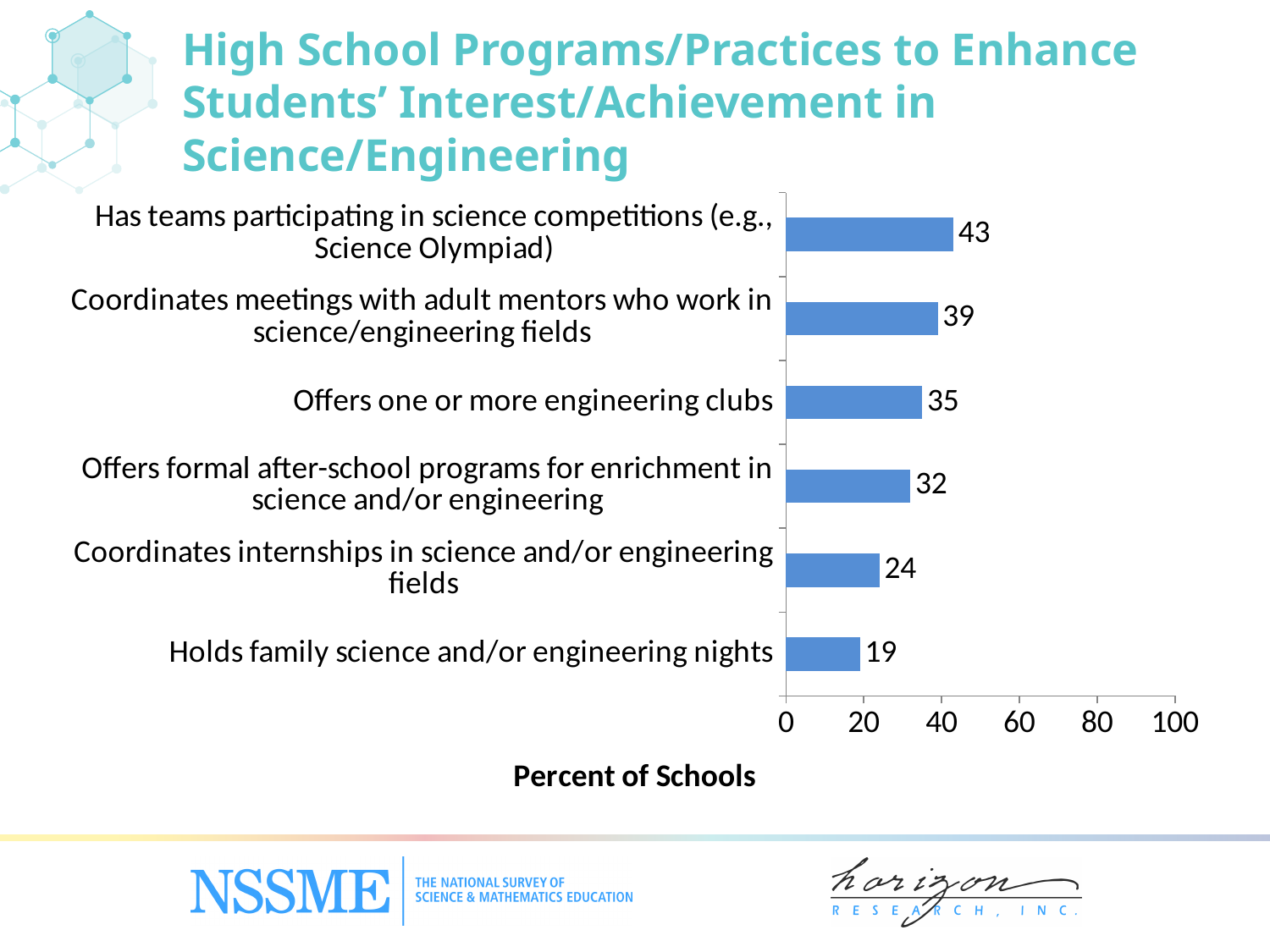
How many programs/practices are shown in the chart? 6 What kind of chart is shown on the slide? Bar chart What percent of schools coordinate internships in science and/or engineering fields? 24 Which program/practice has the lowest percent of schools? Holds family science and/or engineering nights Which is higher: the percent of schools offering one or more engineering clubs or the percent coordinating internships in science and/or engineering fields? Offers one or more engineering clubs What percent of schools have teams participating in science competitions (e.g., Science Olympiad)? 43 What percent of schools hold family science and/or engineering nights? 19 What is the label of the horizontal axis? Percent of Schools Is the value for coordinating meetings with adult mentors who work in science/engineering fields greater or less than 40? less What is the difference in percent of schools between coordinating meetings with adult mentors and offering formal after-school programs for enrichment? 7 What percent of schools offer one or more engineering clubs? 35 Which program/practice has the highest percent of schools? Has teams participating in science competitions (e.g., Science Olympiad)